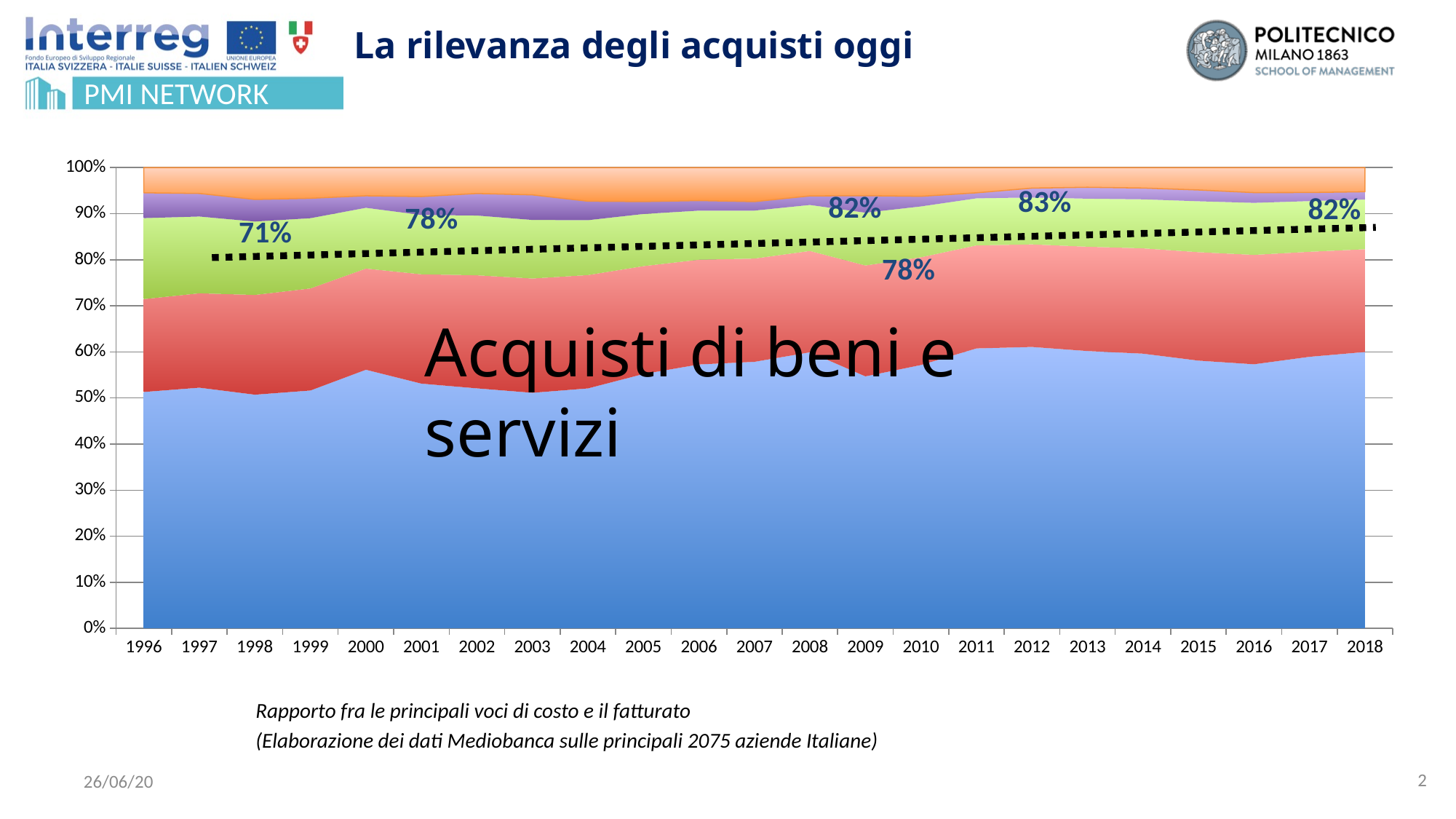
How many years are shown along the x axis of the chart? 23 Is the dotted line value in 2018 greater or less than 90%? less What is the difference between the highest printed label (83%) and the lowest printed label (71%)? 12 percentage points How many coloured areas are stacked in the chart? 5 What kind of chart is shown on the slide? Stacked area chart What is the leftmost percentage label printed on the chart? 71% What is the last year shown on the x axis of the chart? 2018 What is the highest percentage label printed on the chart? 83% What is the rightmost percentage label printed on the chart, at 2018? 82% Is the top of the blue area in 2000 greater or less than 50%? greater What is the first year shown on the x axis of the chart? 1996 Does the dotted line rise or fall from 1997 to 2018? Rises